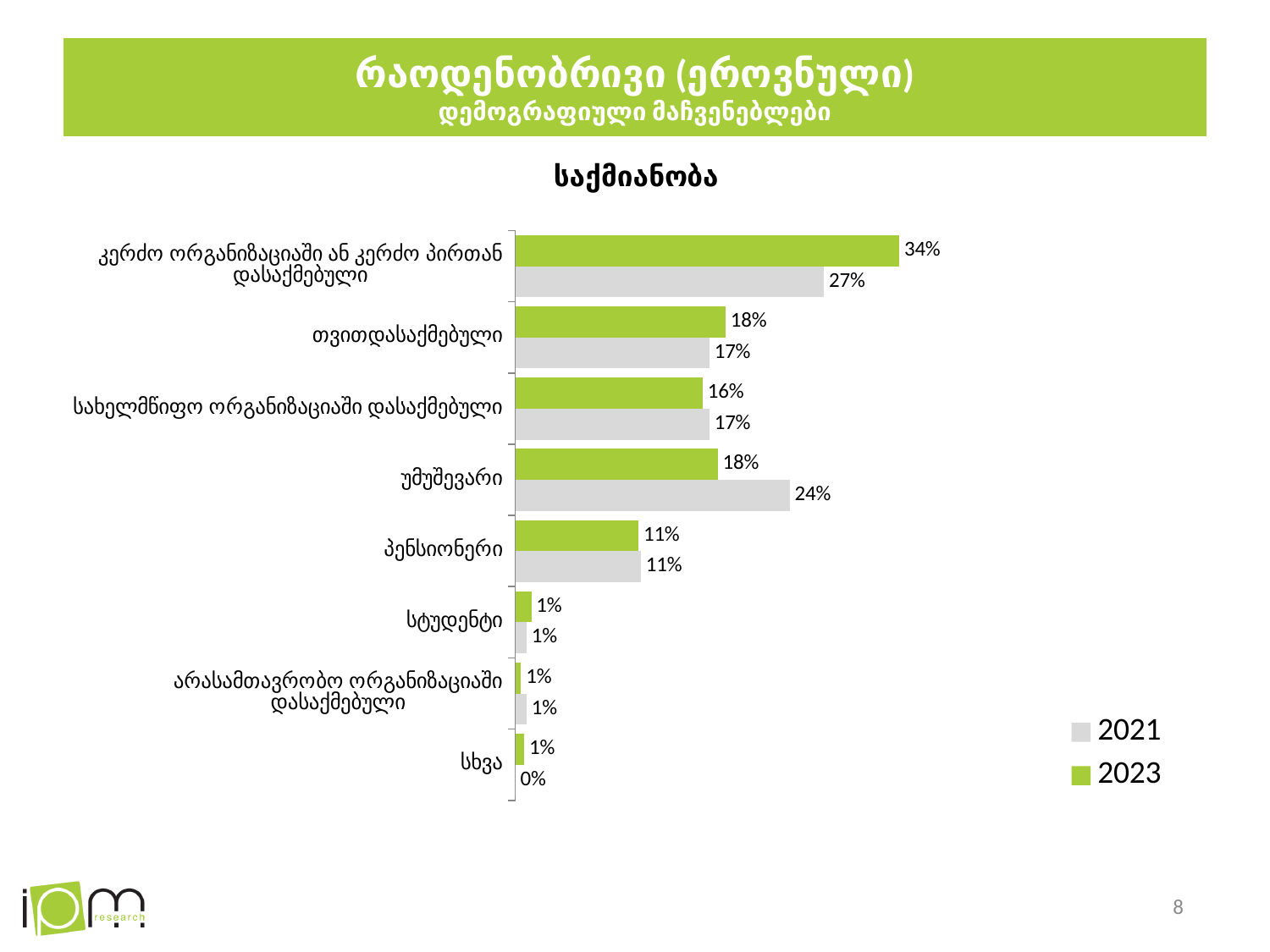
For უმუშევარი, which year has the larger value, 2021 or 2023? 2021 What is the 2021 value for სახელმწიფო ორგანიზაციაში დასაქმებული? 17% For თვითდასაქმებული, which year has the larger value, 2021 or 2023? 2023 What is the 2021 value for კერძო ორგანიზაციაში ან კერძო პირთან დასაქმებული? 27% Which category has the lowest 2021 value? სხვა How many categories are shown in the chart? 8 What type of chart is shown on the slide? Bar chart What is the difference between the 2021 and 2023 values for უმუშევარი? 6% Which category has the highest 2023 value? კერძო ორგანიზაციაში ან კერძო პირთან დასაქმებული How many series does the legend list? 2 What is the difference between the 2023 and 2021 values for კერძო ორგანიზაციაში ან კერძო პირთან დასაქმებული? 7% What is the 2023 value for უმუშევარი? 18%